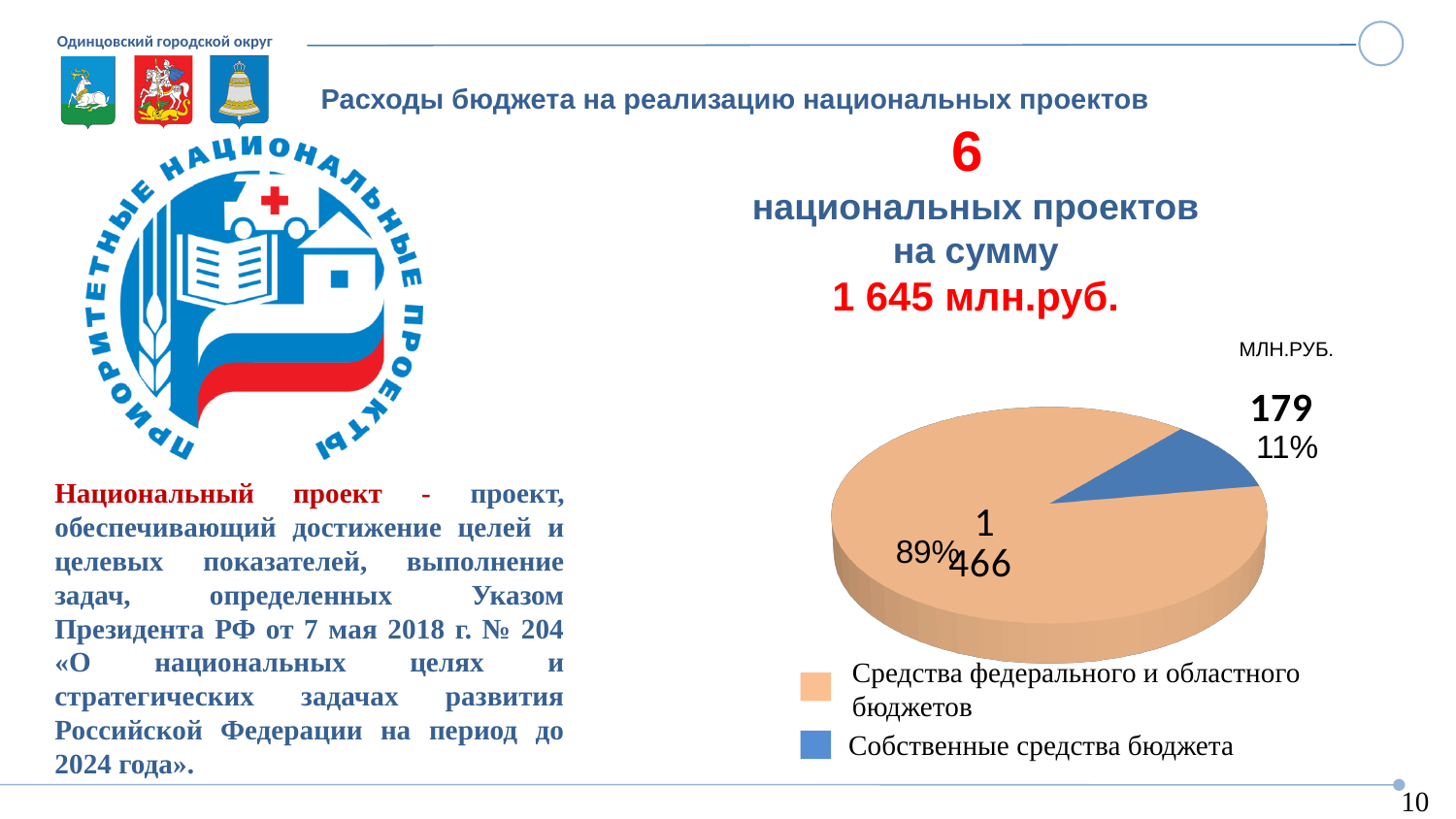
What share of the pie does "Средства федерального и областного бюджетов" represent? 89% How many entries does the legend of the pie chart list? 2 What is the value for "Средства федерального и областного бюджетов" in the pie chart? 1 466 What is the total of the two slices in the pie chart? 1 645 In what units are the values of the pie chart given? млн.руб. What is the difference between the values for "Средства федерального и областного бюджетов" and "Собственные средства бюджета"? 1 287 Which slice of the pie chart is the smallest? Собственные средства бюджета What is the value for "Собственные средства бюджета" in the pie chart? 179 What share of the pie does "Собственные средства бюджета" represent? 11% How many slices does the pie chart have? 2 What kind of chart is shown on the slide? pie chart Which slice of the pie chart is the largest? Средства федерального и областного бюджетов